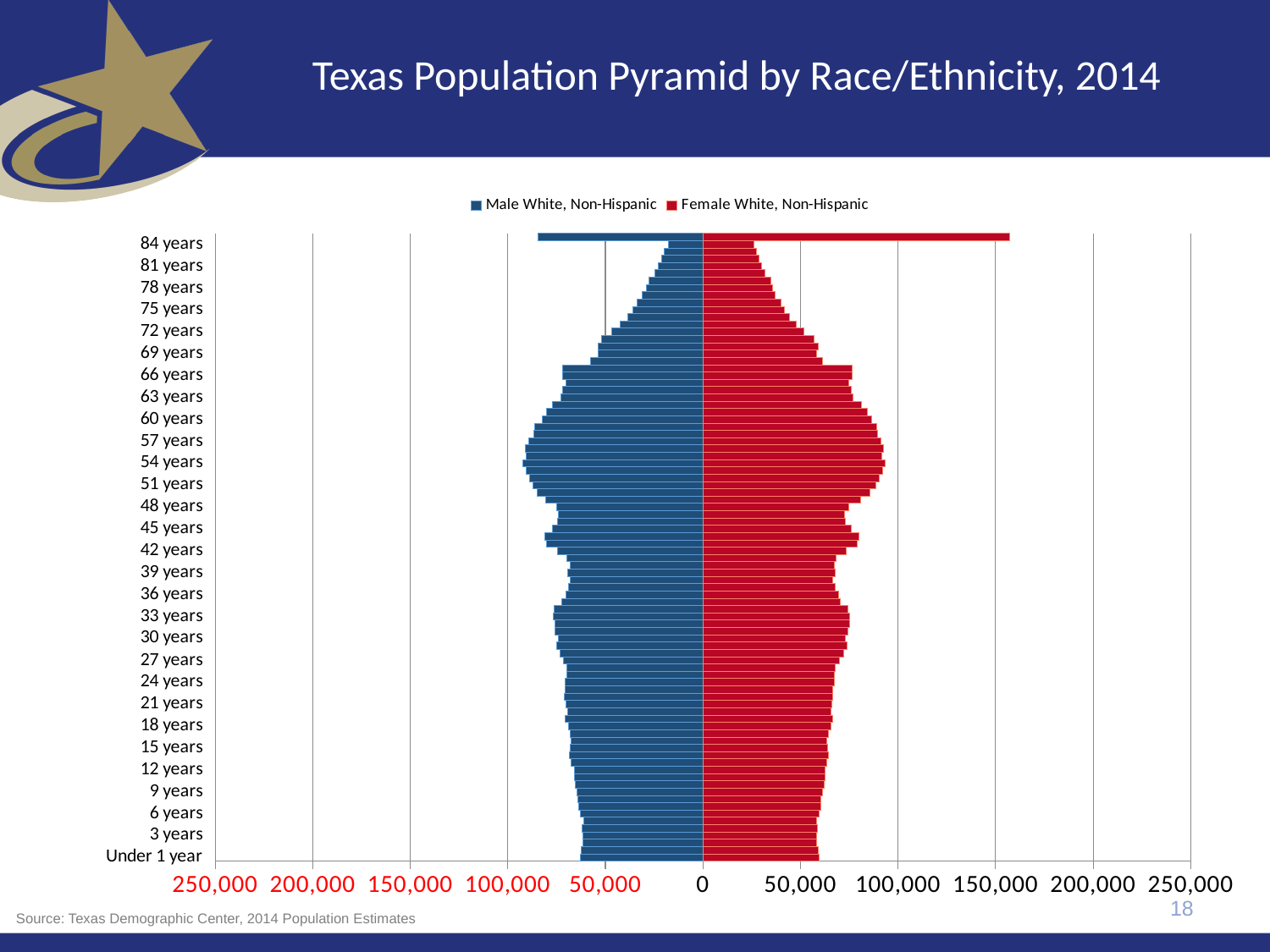
What is the title of the chart? Texas Population Pyramid by Race/Ethnicity, 2014 Is the value for Male White, Non-Hispanic at 54 years greater or less than 50,000? greater How many series does the legend list? 2 For Male White, Non-Hispanic, which is larger: the value at 54 years or the value at 78 years? 54 years Is the value for Female White, Non-Hispanic at 54 years greater or less than 100,000? less At 84 years, which series has the larger value, Male White, Non-Hispanic or Female White, Non-Hispanic? Female White, Non-Hispanic For Male White, Non-Hispanic, do the bars get longer or shorter as age increases from 54 years to 81 years? shorter What are the two series named in the legend? Male White, Non-Hispanic and Female White, Non-Hispanic Is the value for Female White, Non-Hispanic at Under 1 year greater or less than 50,000? greater How many age labels are shown on the vertical axis? 29 What kind of chart is shown on the slide? bar chart